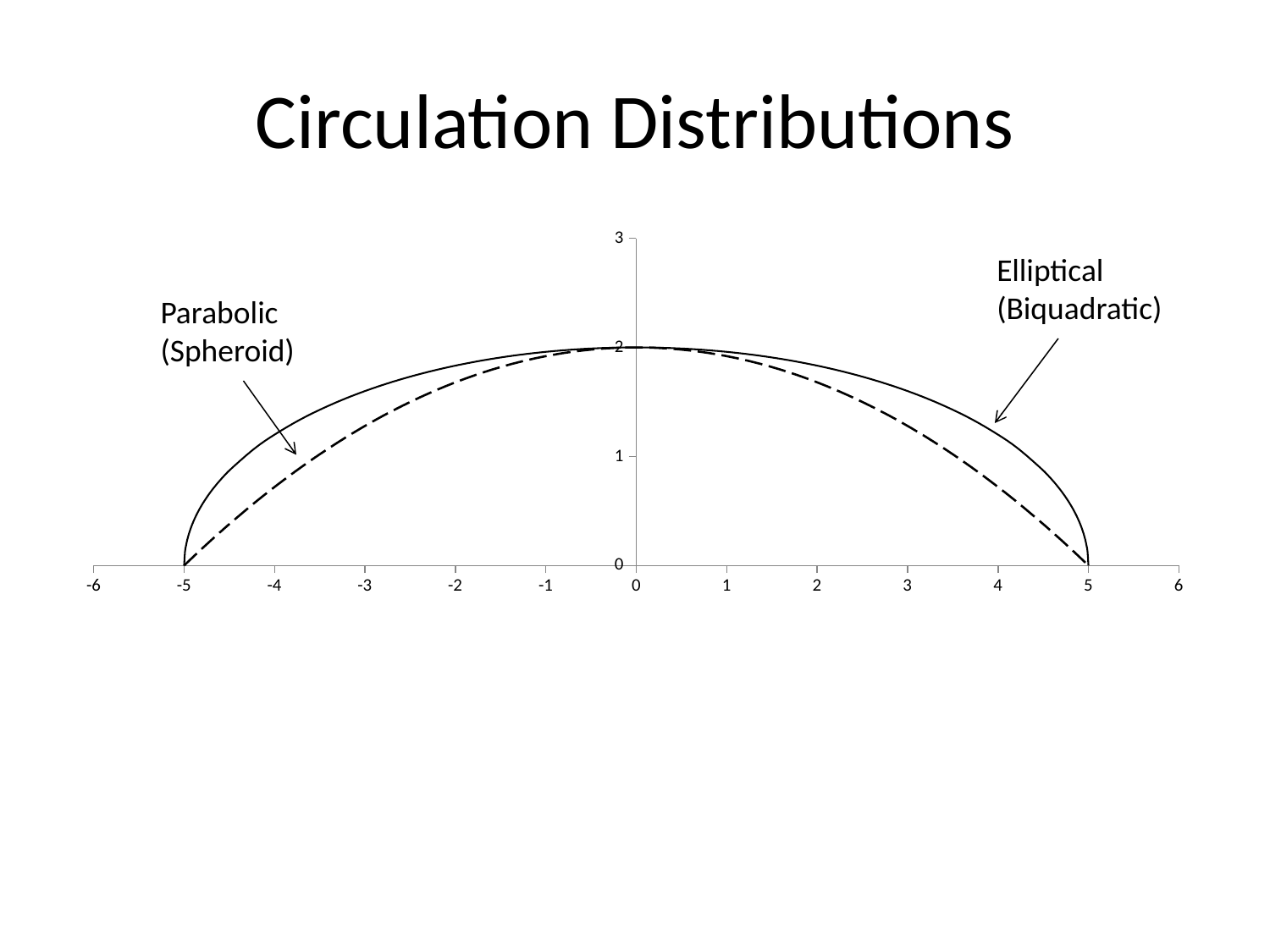
Is the value of the Elliptical (Biquadratic) curve at x = 4 greater or less than 1? greater At what x value do both curves reach their peak? 0 What is the maximum value reached by the Elliptical (Biquadratic) curve? 2 What is the value of the Elliptical (Biquadratic) curve at x = -5? 0 At x = -4, which curve has the higher value, Parabolic (Spheroid) or Elliptical (Biquadratic)? Elliptical (Biquadratic) Do the curves rise or fall as x increases from 0 to 5? fall How many curves are plotted on the chart? 2 What is the title of the chart? Circulation Distributions Which curve is drawn with a dashed line? Parabolic (Spheroid) What is the value of the Parabolic (Spheroid) curve at x = 5? 0 What kind of chart is shown on the slide? line chart Is the value of the Parabolic (Spheroid) curve at x = 4 greater or less than 1? less